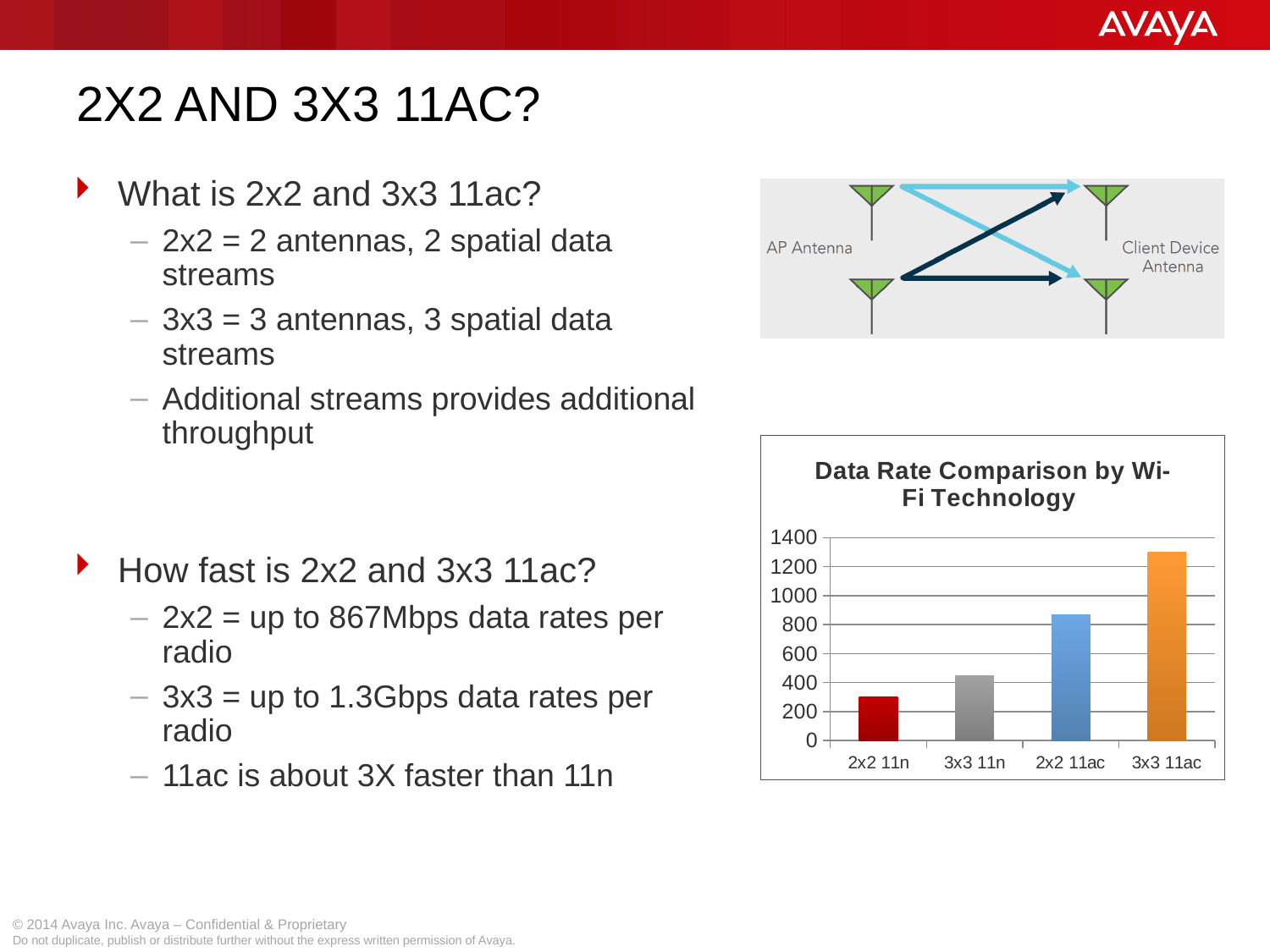
Is the value for 2x2 11n greater or less than 400? less Which category has the lowest value in the chart? 2x2 11n What is the title of the chart? Data Rate Comparison by Wi-Fi Technology Is the value for 3x3 11ac greater or less than 1200? greater Is the value for 2x2 11ac greater or less than 1000? less Which category has the highest value in the chart? 3x3 11ac Do the values rise or fall from left to right along the x axis? rise How many categories are plotted in the chart? 4 Which is larger, the value for 2x2 11ac or the value for 3x3 11n? 2x2 11ac What colour is the bar for 3x3 11ac? orange What kind of chart is shown on the slide? bar chart